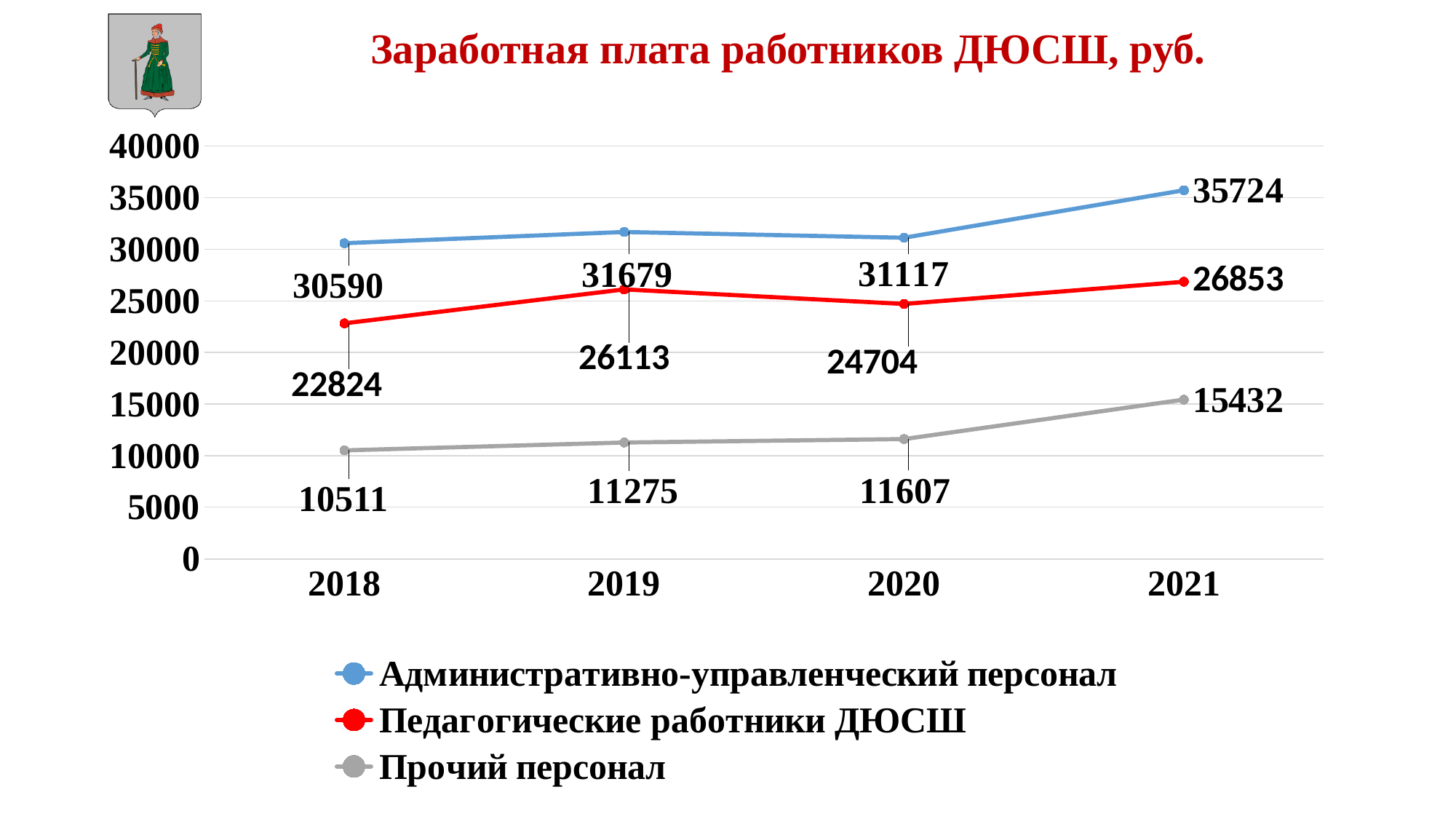
What kind of chart is shown on the slide? line chart How many years are shown on the x axis? 4 What is the value for Педагогические работники ДЮСШ in 2019? 26113 In which year is the value for Прочий персонал highest? 2021 What is the difference between the 2021 and 2018 values for Педагогические работники ДЮСШ? 4029 In which year is the value for Административно-управленческий персонал lowest? 2018 What is the value for Педагогические работники ДЮСШ in 2020? 24704 What is the value for Прочий персонал in 2018? 10511 What is the value for Административно-управленческий персонал in 2021? 35724 How many series does the legend list? 3 Which is larger in 2020: the value for Административно-управленческий персонал or for Педагогические работники ДЮСШ? Административно-управленческий персонал What is the title of the chart? Заработная плата работников ДЮСШ, руб.